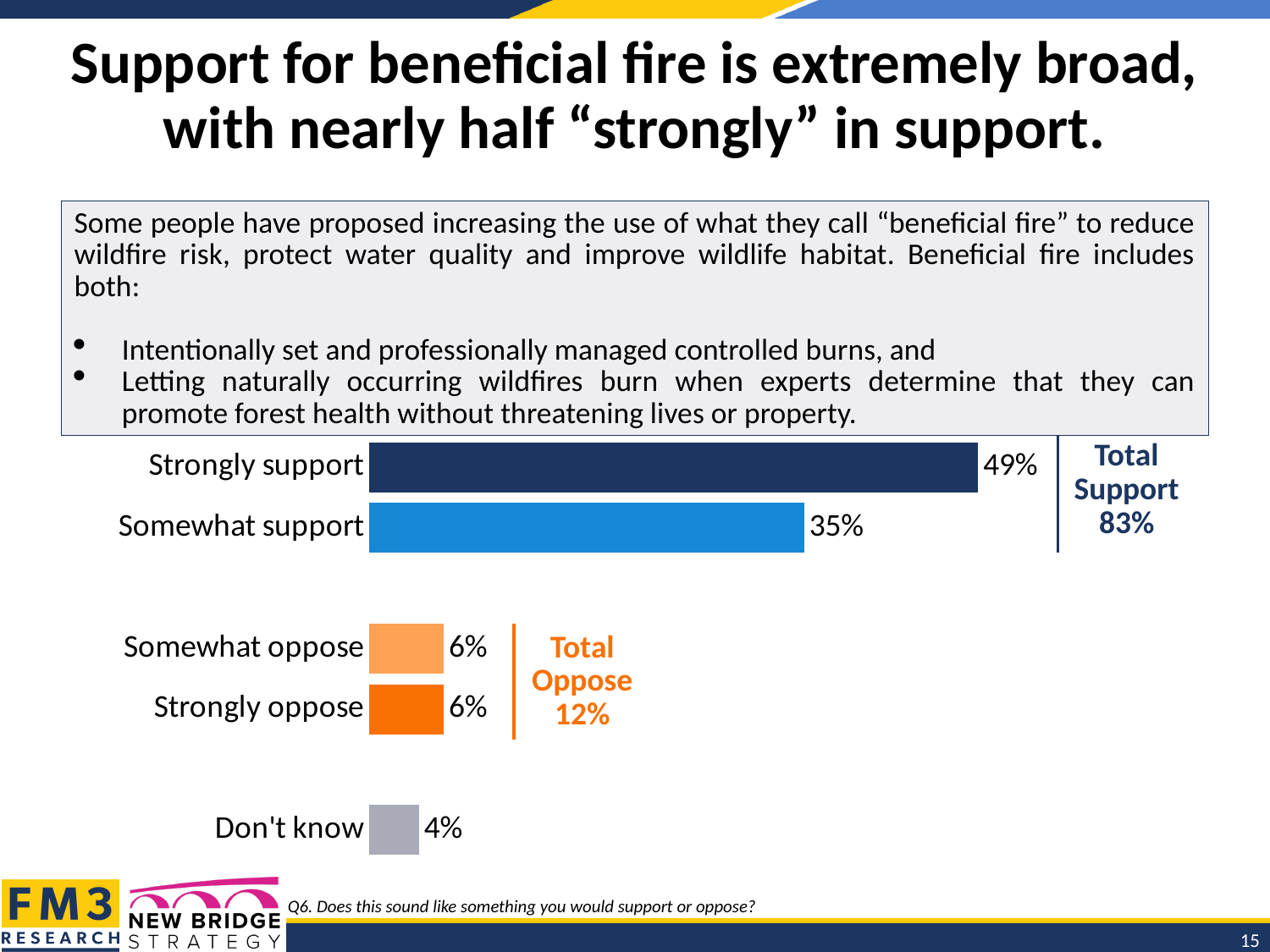
How many response categories are shown in the chart? 5 What percentage of respondents somewhat support beneficial fire? 35% What percentage of respondents strongly oppose beneficial fire? 6% Which response category has the highest percentage? Strongly support What is the Total Oppose percentage shown on the chart? 12% Which response category has the lowest percentage? Don't know What percentage of respondents answered 'Don't know'? 4% What percentage of respondents strongly support beneficial fire? 49% What is the difference between the 'Strongly support' and 'Somewhat support' percentages? 14 percentage points What is the Total Support percentage shown on the chart? 83% What type of chart is shown on the slide? Bar chart Which is larger, the percentage for 'Somewhat support' or for 'Somewhat oppose'? Somewhat support